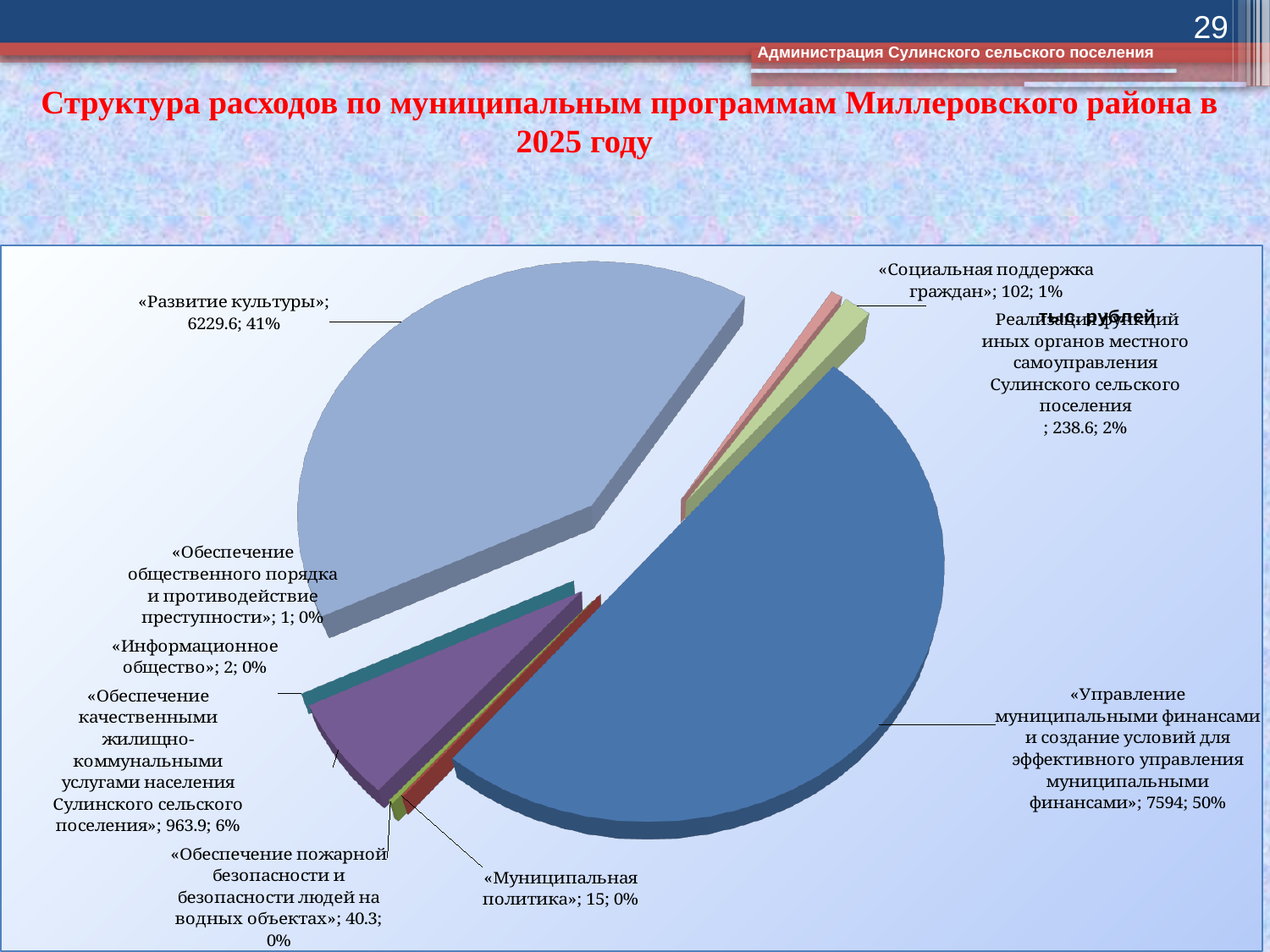
What is the difference between the value for «Управление муниципальными финансами...» (7594) and «Развитие культуры» (6229.6)? 1364.4 Which is larger: the value for «Муниципальная политика» or the value for «Обеспечение пожарной безопасности и безопасности людей на водных объектах»? «Обеспечение пожарной безопасности и безопасности людей на водных объектах» What share of the pie does «Развитие культуры» represent? 41% Which category has the smallest value? «Обеспечение общественного порядка и противодействие преступности» What is the value for «Социальная поддержка граждан»? 102 What kind of chart is shown on the slide? pie chart What is the value for «Обеспечение качественными жилищно-коммунальными услугами населения Сулинского сельского поселения»? 963.9 What share of the pie does «Реализация функций иных органов местного самоуправления Сулинского сельского поселения» represent? 2% What is the value for «Управление муниципальными финансами и создание условий для эффективного управления муниципальными финансами»? 7594 Which category has the largest slice of the pie? «Управление муниципальными финансами и создание условий для эффективного управления муниципальными финансами» What is the value for «Развитие культуры»? 6229.6 How many categories (slices) does the pie chart have? 9